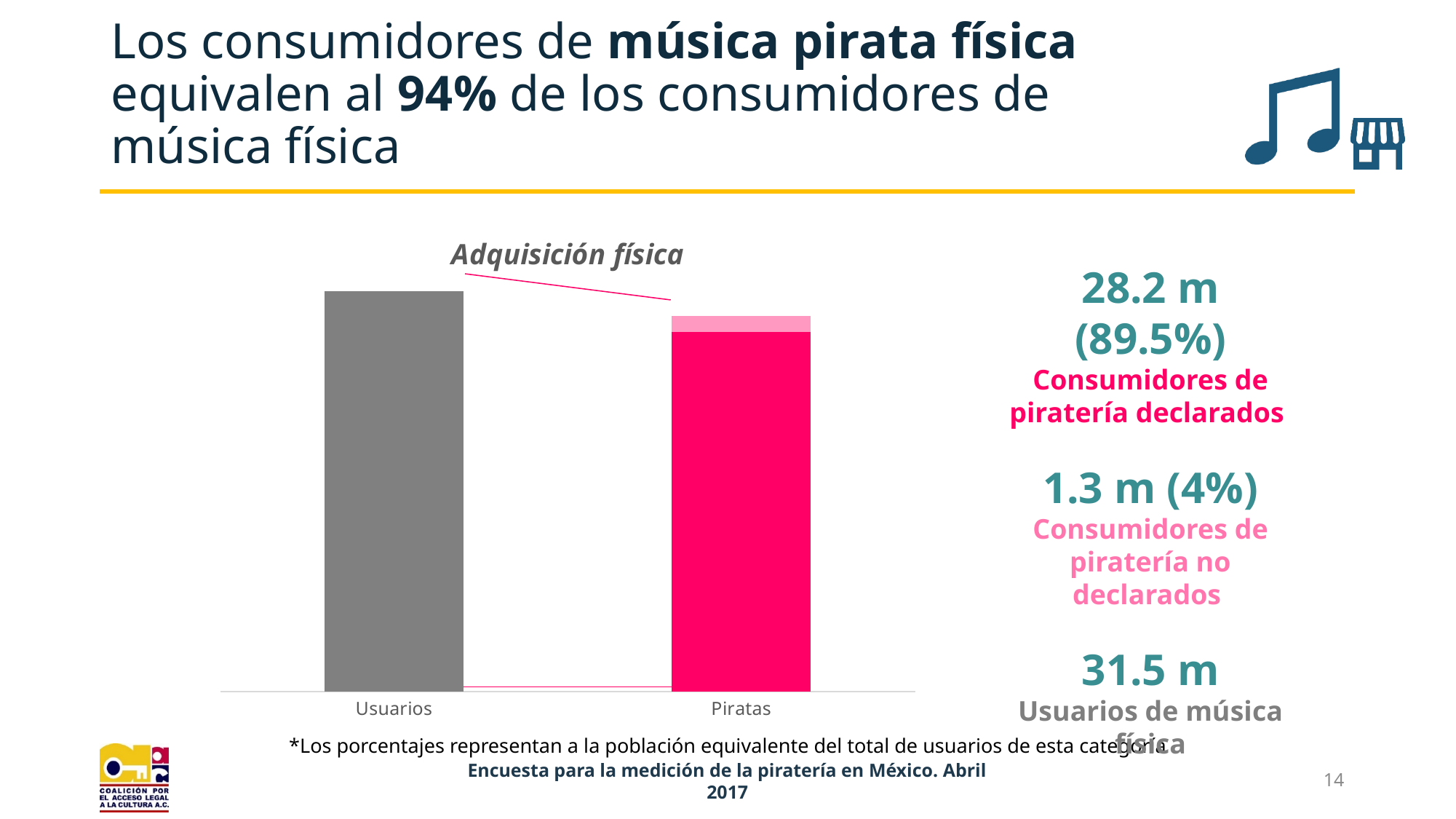
Which category has the lowest bar in the chart? Piratas What is the total of the Piratas stacked bar, combining declared and undeclared piracy consumers? 29.5 m Which segment of the Piratas bar is larger, the declared (dark pink) or the undeclared (light pink) piracy consumers? declared (dark pink) Which category has the taller bar, Usuarios or Piratas? Usuarios What is the difference between the number of physical music users (31.5 m) and declared piracy consumers (28.2 m)? 3.3 m What is the title of the chart? Adquisición física How many users of physical music (Usuarios de música física) does the slide report? 31.5 m What value is given for undeclared piracy consumers (Consumidores de piratería no declarados)? 1.3 m (4%) What value is given for declared piracy consumers (Consumidores de piratería declarados)? 28.2 m (89.5%) How many categories are shown on the x axis of the chart? 2 What kind of chart is shown on the slide? bar chart Which category has the highest bar in the chart? Usuarios